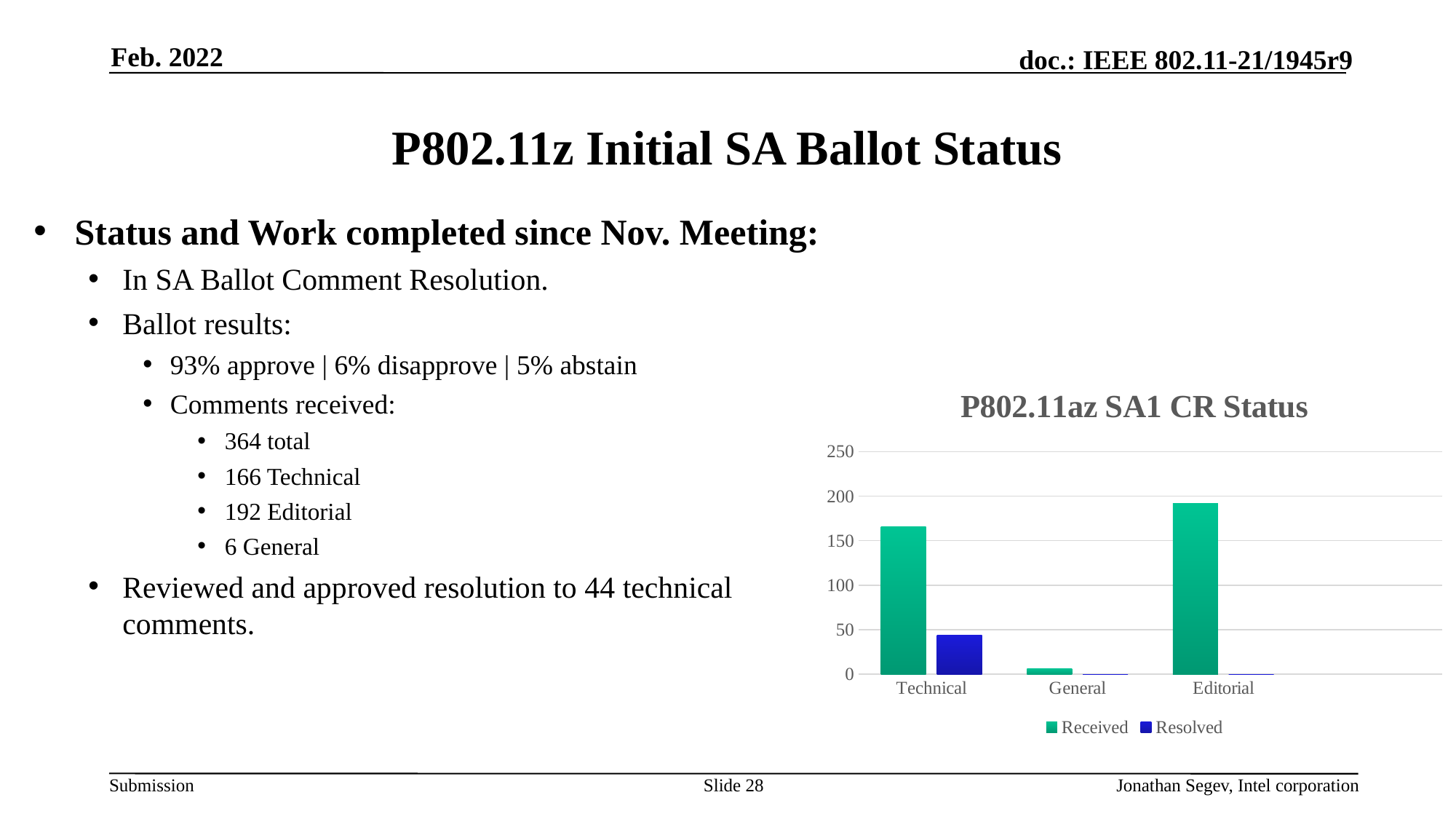
How many categories are shown on the x axis of the chart? 3 Is the Received value for General greater or less than 50? less What kind of chart is shown on the slide? bar chart Which is larger for Technical, the Received value or the Resolved value? Received Is the Received value for Technical greater or less than 150? greater How many series does the chart legend list? 2 Is the Resolved value for Technical greater or less than 50? less Which is larger, the Received value for Technical or the Received value for Editorial? Editorial Which category has the lowest Received value? General What is the title of the chart? P802.11az SA1 CR Status Which category has the highest Received value? Editorial Which series is shown in blue in the chart legend? Resolved